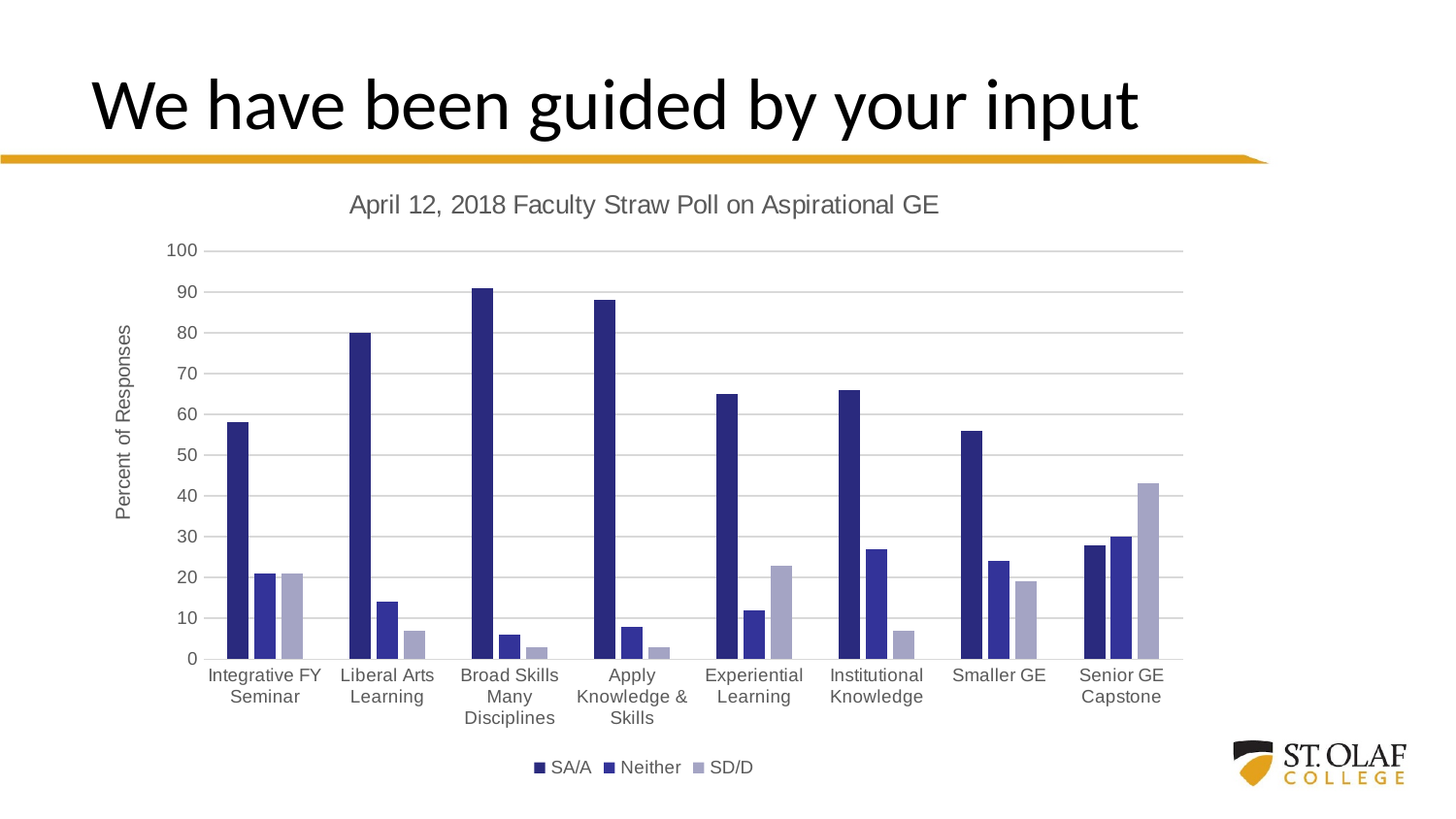
Which category has the highest SA/A value? Broad Skills Many Disciplines How many series does the legend list? 3 Is the Neither value for Broad Skills Many Disciplines greater or less than 10? less Is the SD/D value for Experiential Learning greater or less than 20? greater Which is larger for Senior GE Capstone, the SA/A value or the SD/D value? SD/D Is the SA/A value for Apply Knowledge & Skills greater or less than 80? greater How many categories are shown on the x axis? 8 What type of chart is shown on the slide? bar chart What is the label of the y axis? Percent of Responses What is the title of the chart? April 12, 2018 Faculty Straw Poll on Aspirational GE Which category has the lowest SA/A value? Senior GE Capstone Which category has the highest SD/D value? Senior GE Capstone